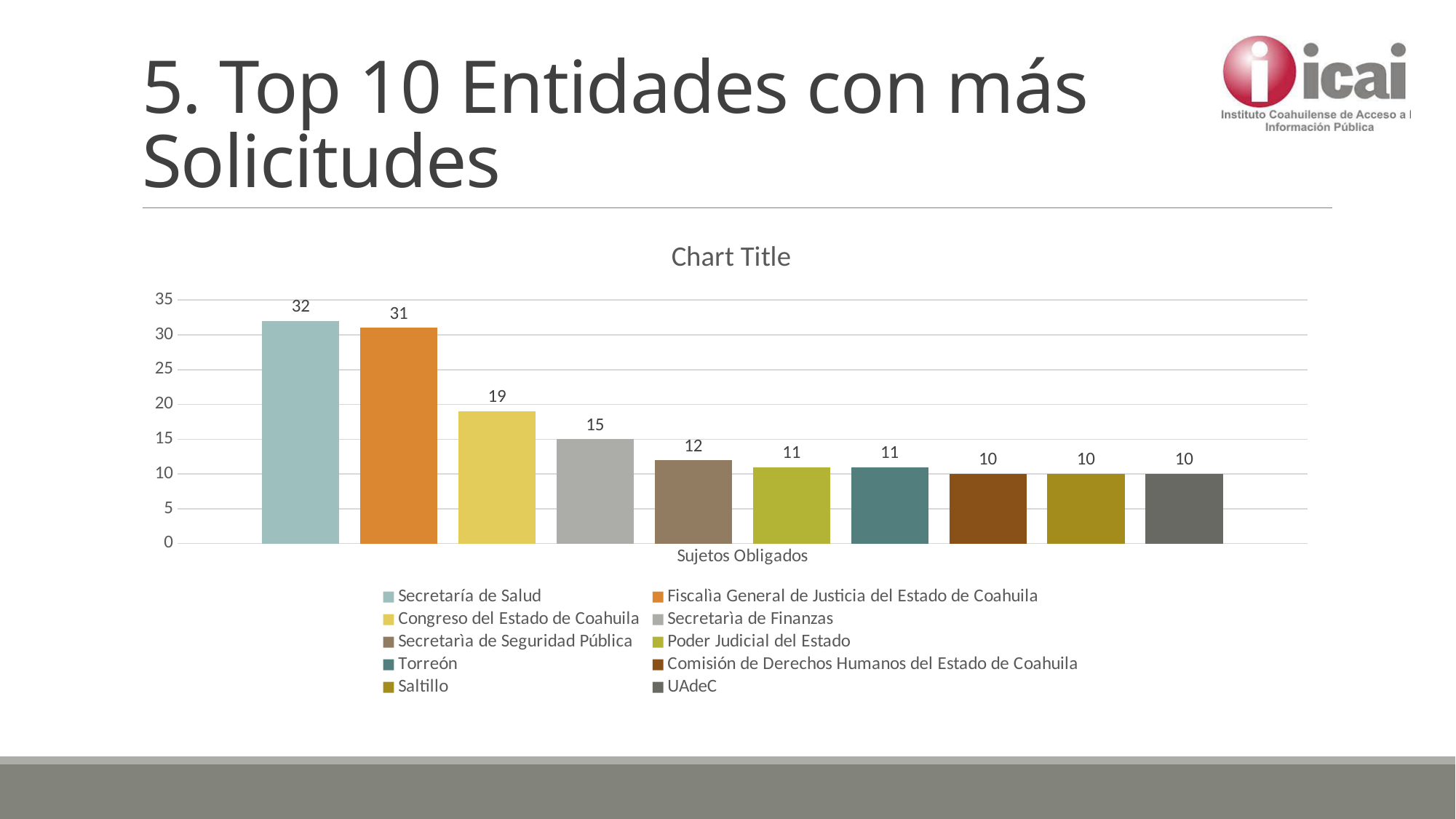
What is the difference between the values for Congreso del Estado de Coahuila and Secretarìa de Seguridad Pública? 7 What is the value for Secretaría de Salud? 32 What kind of chart is shown on the slide? Bar chart What is the value for Fiscalìa General de Justicia del Estado de Coahuila? 31 What is the difference between the values for Secretaría de Salud and Fiscalìa General de Justicia del Estado de Coahuila? 1 How many series does the legend list? 10 Which entity has the highest value? Secretaría de Salud Which is larger, the value for Congreso del Estado de Coahuila or the value for Secretarìa de Finanzas? Congreso del Estado de Coahuila What is the label shown on the horizontal axis of the chart? Sujetos Obligados What is the value for Secretarìa de Finanzas? 15 What is the value for Torreón? 11 What is the value for Congreso del Estado de Coahuila? 19